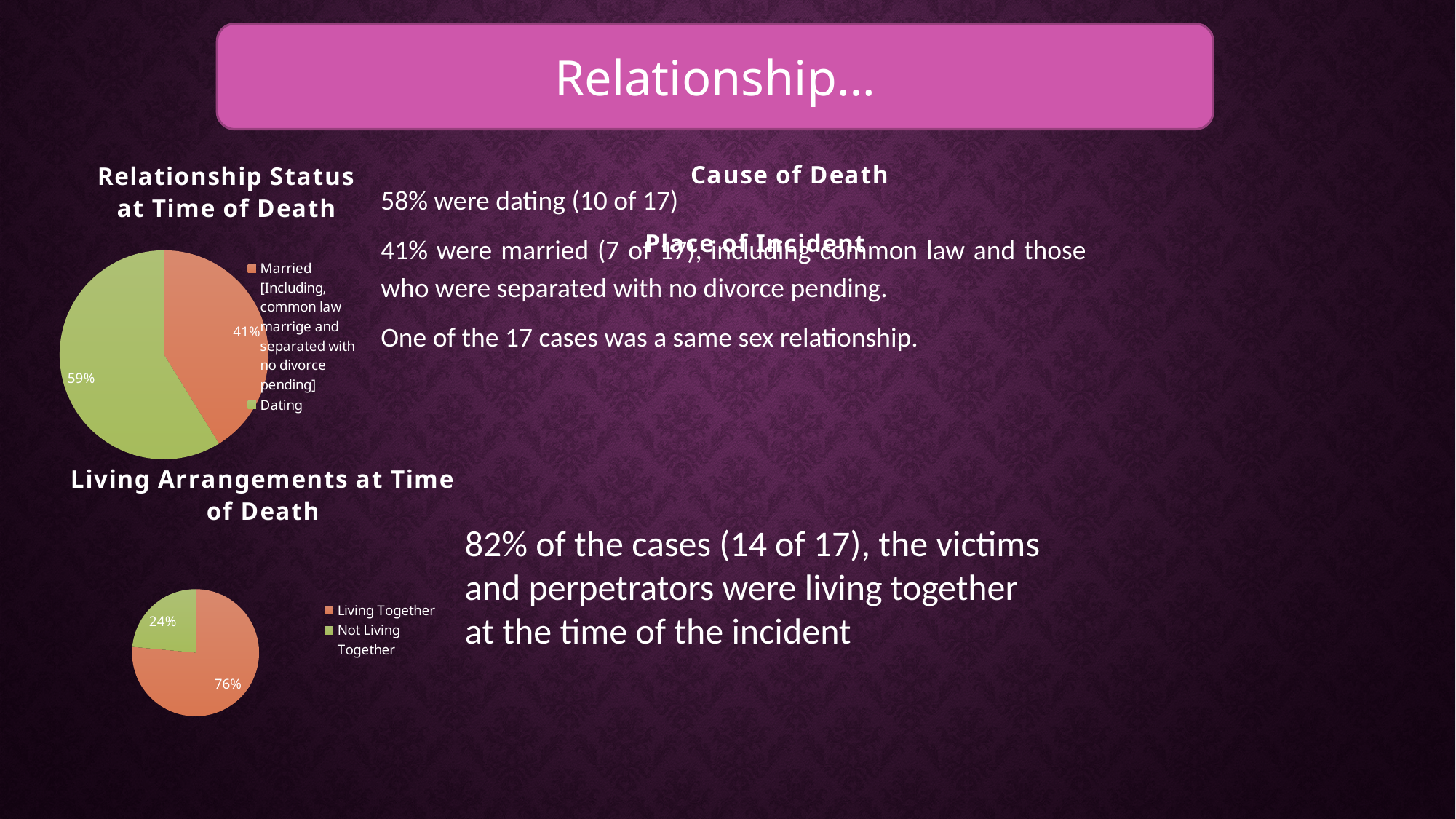
In the 'Relationship Status at Time of Death' chart, what is the difference in percentage points between the Dating and Married slices? 18 In the 'Living Arrangements at Time of Death' chart, what percentage is shown for Not Living Together? 24% What kind of chart is the 'Relationship Status at Time of Death' chart? Pie chart In the 'Living Arrangements at Time of Death' chart, what share of the pie is Living Together? 76% In the 'Relationship Status at Time of Death' chart, what share of the pie is Dating? 59% In the 'Living Arrangements at Time of Death' chart, what is the difference in percentage points between Living Together and Not Living Together? 52 How many entries does the legend of the 'Relationship Status at Time of Death' chart list? 2 In the 'Living Arrangements at Time of Death' chart, which category has the smallest slice? Not Living Together In the 'Relationship Status at Time of Death' chart, which category has the largest slice? Dating How many slices does the 'Living Arrangements at Time of Death' pie chart have? 2 In the 'Relationship Status at Time of Death' chart, what percentage is shown for the Married slice? 41% In the 'Living Arrangements at Time of Death' chart, which is larger: Living Together or Not Living Together? Living Together